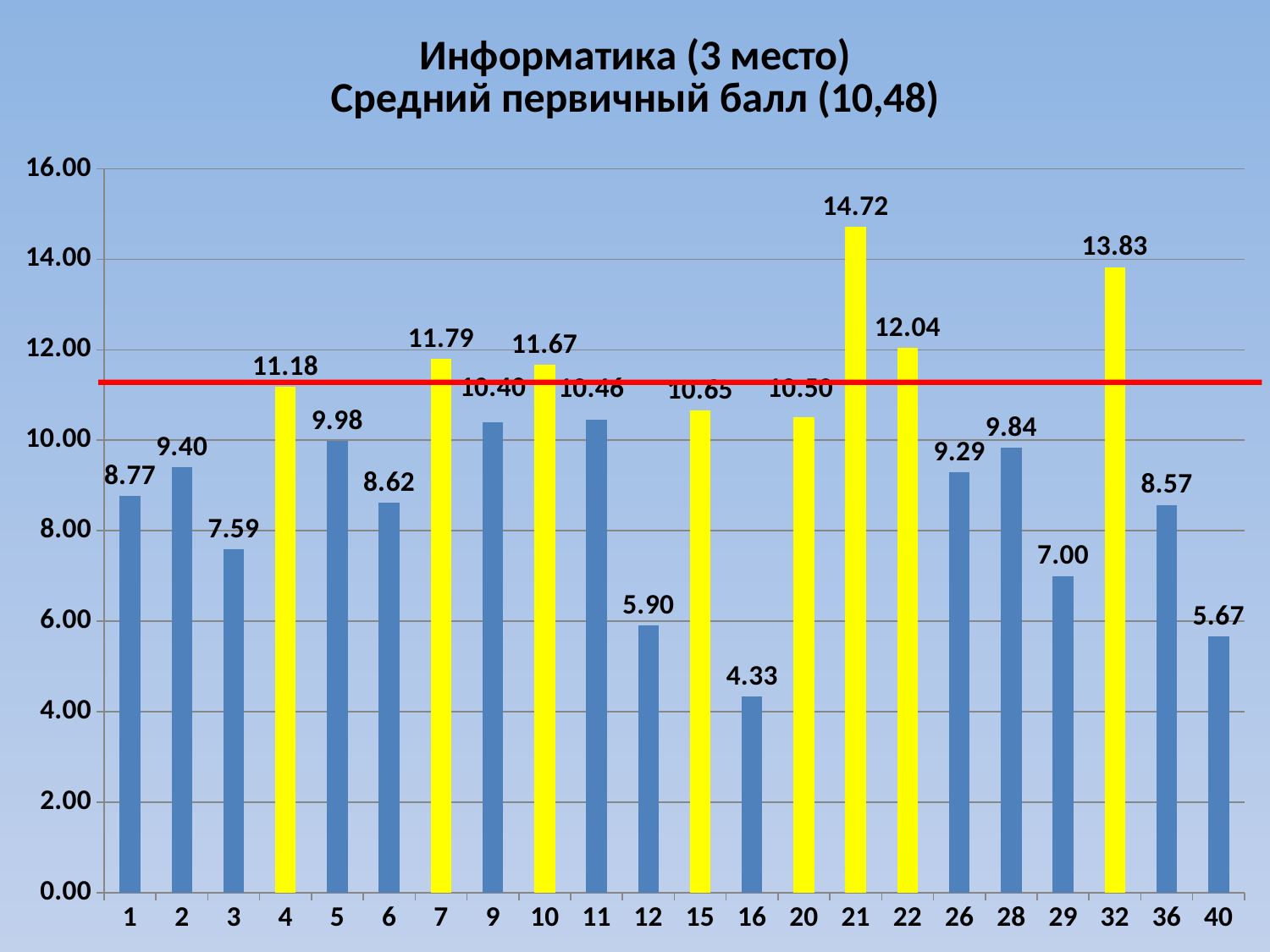
How many bars are coloured yellow? 8 What is the value for category 16? 4.33 Is the value for category 22 greater or less than 12.00? greater How many categories are shown on the x axis? 22 What kind of chart is shown on the slide? bar chart What is the value for category 32? 13.83 What is the difference between the values for categories 21 and 32? 0.89 What is the value for category 21? 14.72 Which is larger, the value for category 7 or the value for category 10? 7 Which category has the lowest value? 16 Which category has the highest value? 21 What is the difference between the values for categories 12 and 40? 0.23